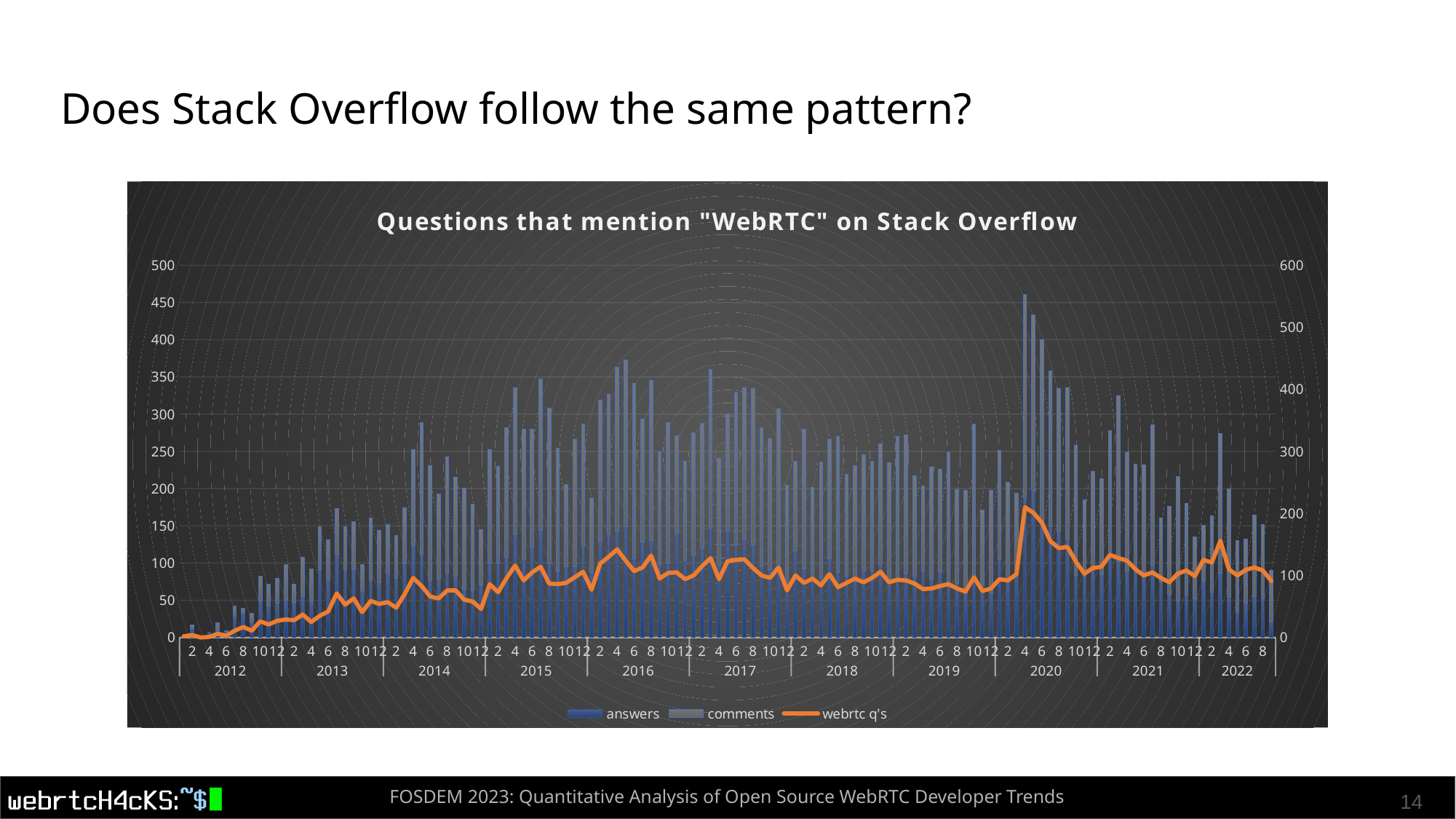
What kind of chart is this? Combined bar and line chart Which year shows the lowest values for all three series? 2012 Is the tallest bar in 2020 greater or less than 400 on the left axis? greater In which year does the tallest bar on the chart occur? 2020 How many series does the chart's legend list? 3 Which series is drawn as an orange line? webrtc q's Does the webrtc q's line rise or fall from 2012 to 2014? rise What is the title of the chart? Questions that mention "WebRTC" on Stack Overflow Is the peak value of the webrtc q's line in 2020 greater or less than 100? greater Does the webrtc q's line rise or fall from its 2020 peak to the end of 2022? fall In which year does the orange webrtc q's line reach its highest peak? 2020 How many years are labelled along the x axis? 11